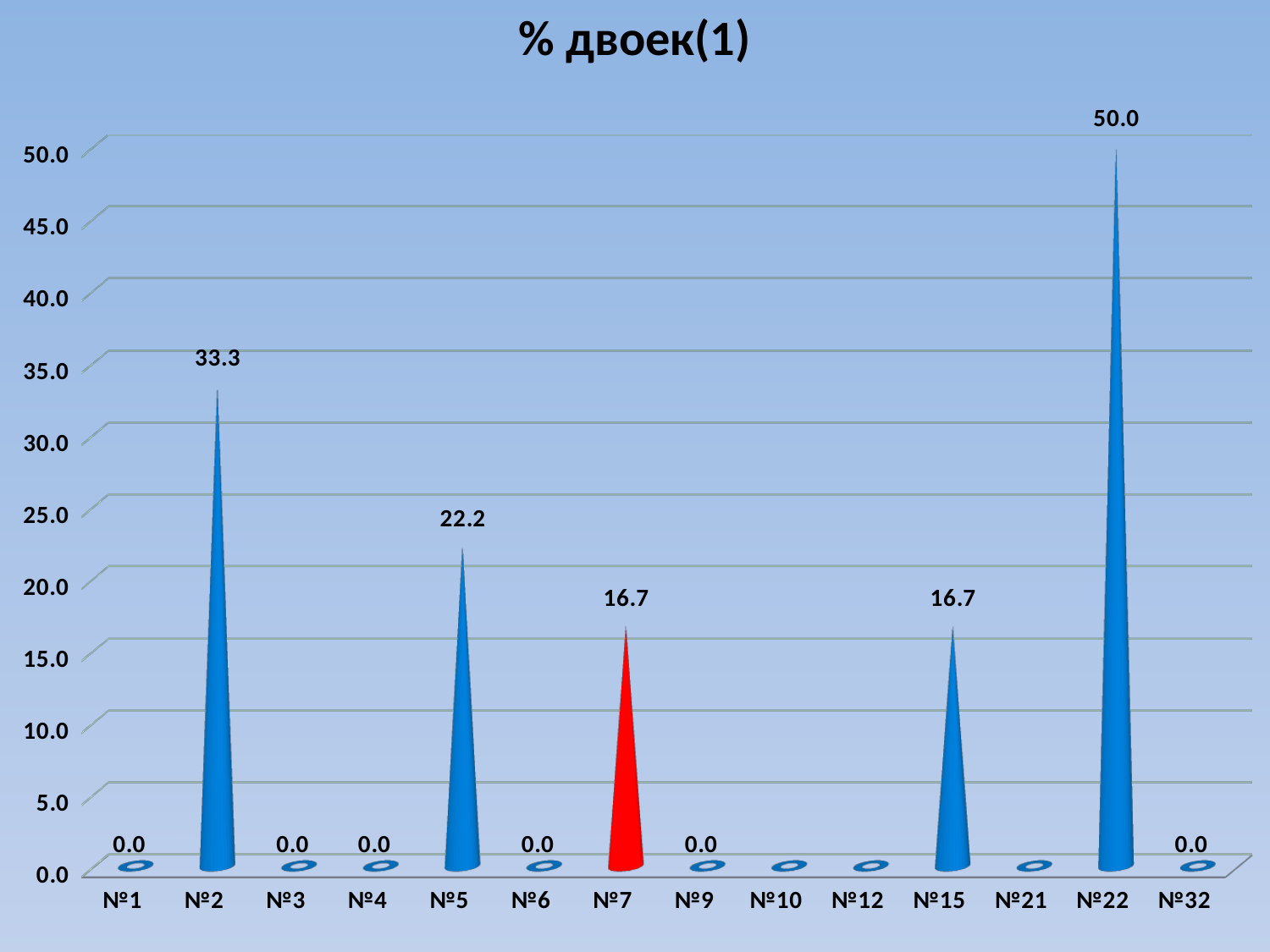
What is the value for №22? 50.0 What kind of chart is shown on the slide? bar chart What is the difference between the values for №22 and №2? 16.7 What is the value for №15? 16.7 How many categories are shown on the x axis? 14 What is the difference between the values for №2 and №5? 11.1 Which category has the highest value? №22 What is the value for №2? 33.3 Which category's bar is coloured red? №7 Which is larger, the value for №5 or the value for №7? №5 What is the value for №5? 22.2 Is the value for №2 greater or less than 30.0? greater